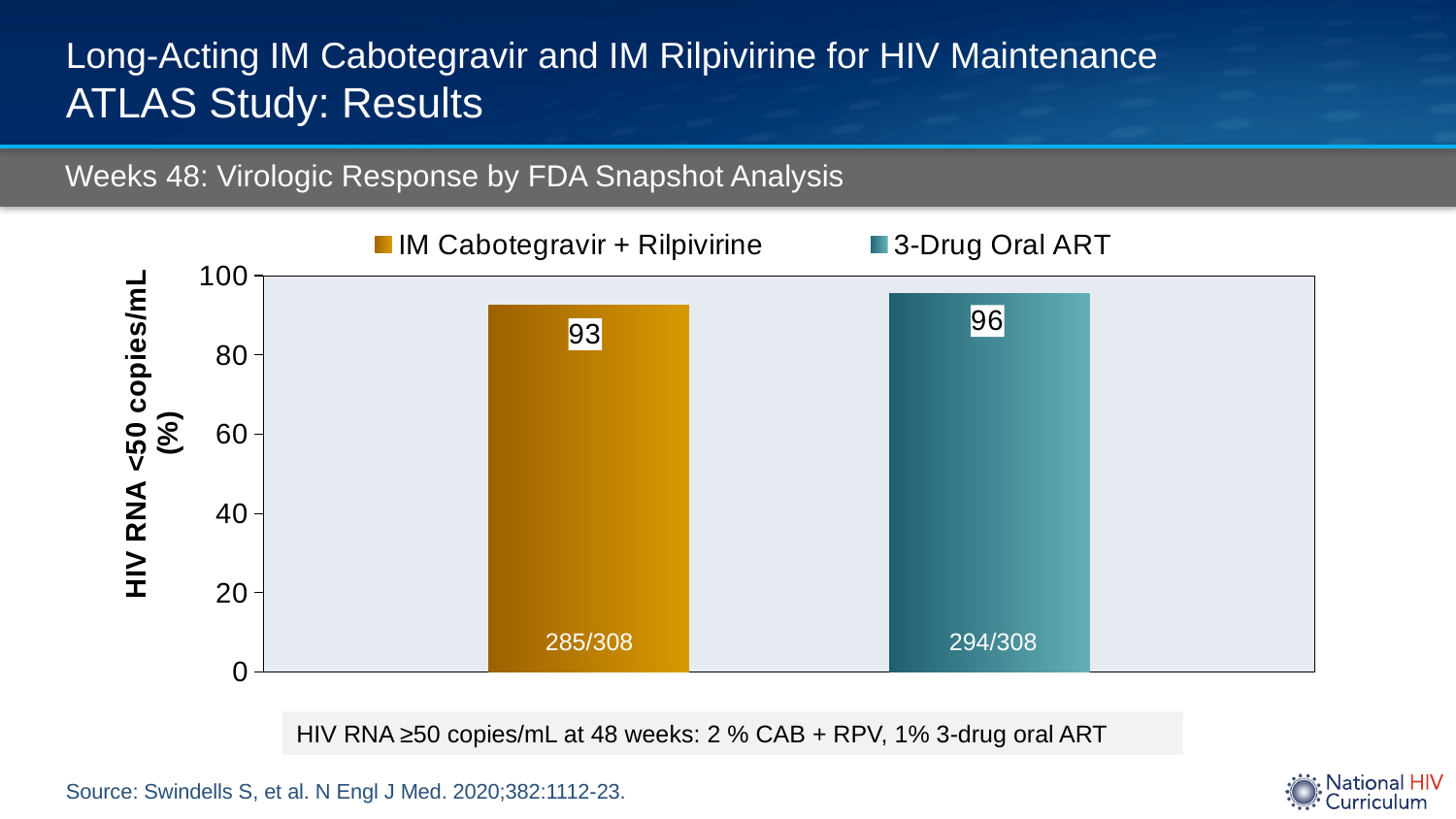
Which series has the higher value, IM Cabotegravir + Rilpivirine or 3-Drug Oral ART? 3-Drug Oral ART What is the value for 3-Drug Oral ART? 96 Which series has the lowest value? IM Cabotegravir + Rilpivirine What is the difference between the 3-Drug Oral ART value and the IM Cabotegravir + Rilpivirine value? 3 Is the value for IM Cabotegravir + Rilpivirine greater or less than 80? greater How many bars are plotted in the chart? 2 What fraction is printed on the 3-Drug Oral ART bar? 294/308 What is the value for IM Cabotegravir + Rilpivirine? 93 What kind of chart is shown? bar chart What fraction is printed on the IM Cabotegravir + Rilpivirine bar? 285/308 What is the y-axis label of the chart? HIV RNA <50 copies/mL (%) How many series does the legend list? 2